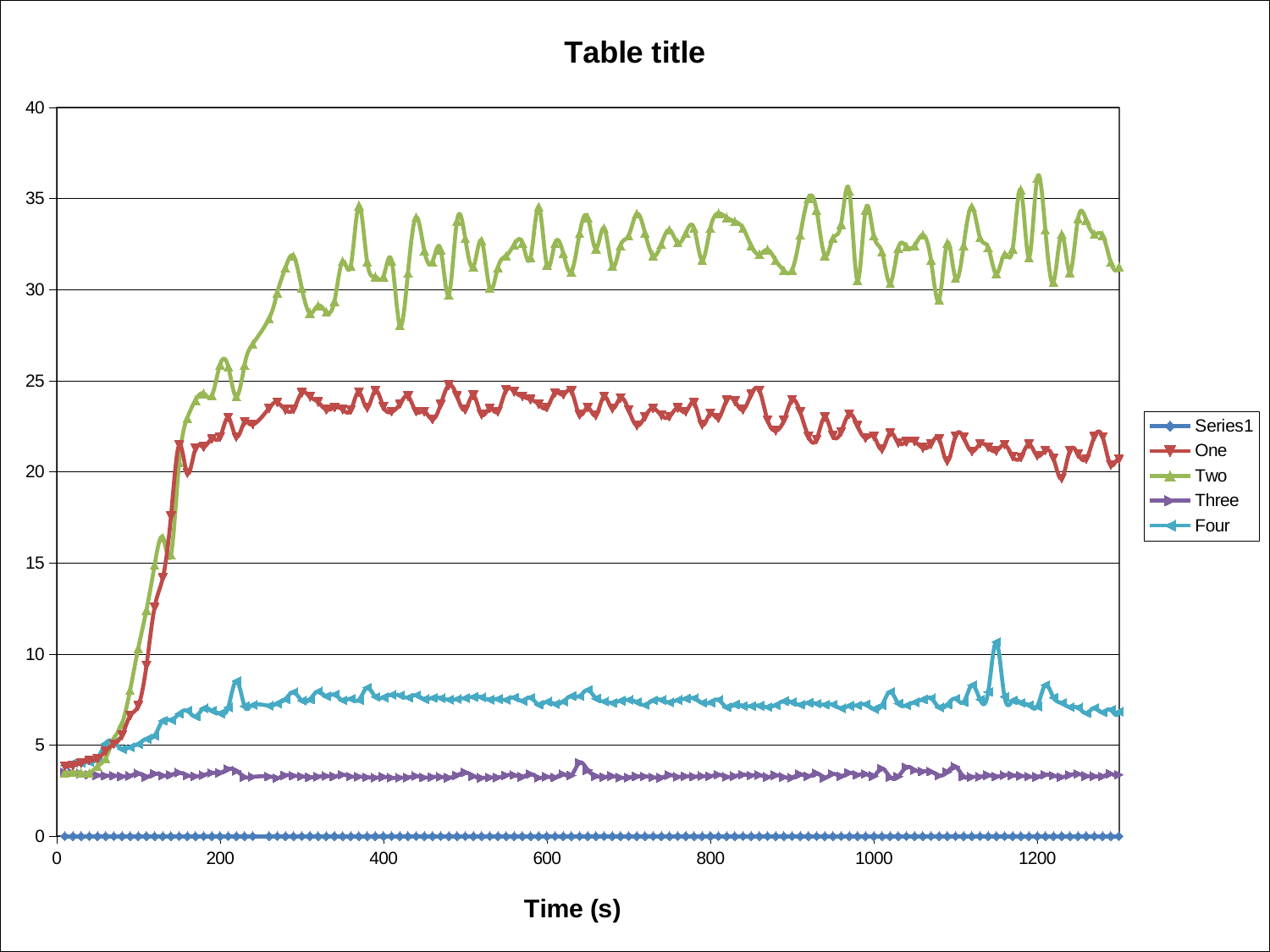
Between time 0 and 300 s, do the values for Two rise or fall? rise What is the title of the chart? Table title Is the value for Four at time 600 s greater or less than 10? less Is the value for One at time 800 s greater or less than 25? less Which series has the highest values at time 800 s? Two Which series has the lowest values at time 800 s? Series1 What kind of chart is shown on the slide? line chart Is the value for Two at time 800 s greater or less than 30? greater How many series does the legend list? 5 What value does Series1 hold across the whole time range? 0 What is the label of the x axis? Time (s) At time 600 s, which series has the larger value, One or Four? One